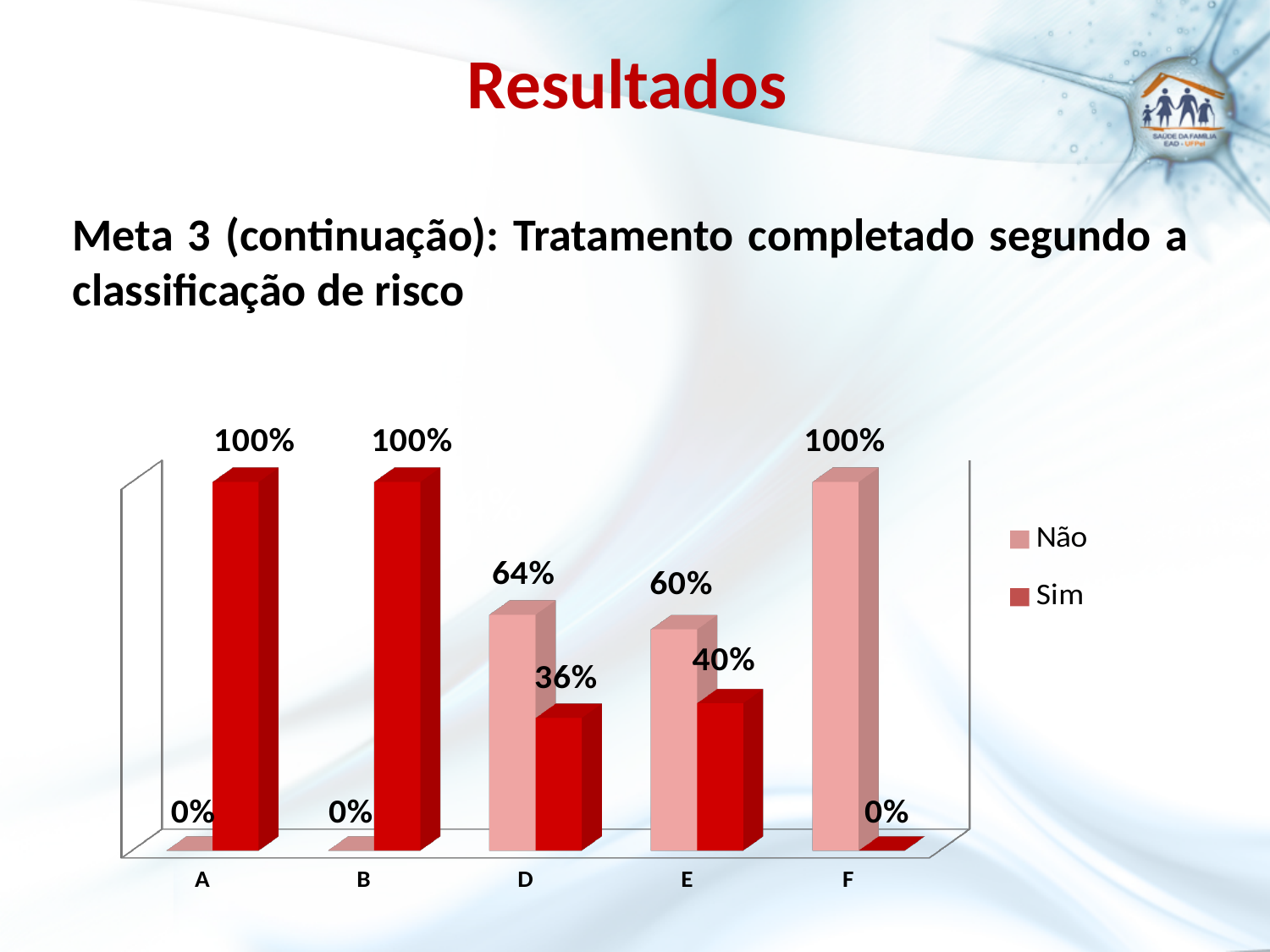
What is the value of the "Não" series for category E? 60% What is the difference between the "Não" and "Sim" values for category D? 28% Which category has the highest "Não" value? F What kind of chart is shown on the slide? Bar chart How many series does the legend list? 2 Which series is shown in dark red in the legend? Sim How many categories are shown on the x axis? 5 For category E, which is larger, the "Não" value or the "Sim" value? Não What is the value of the "Sim" series for category A? 100% What is the value of the "Sim" series for category D? 36% Which category has the lowest "Sim" value? F What is the value of the "Não" series for category F? 100%